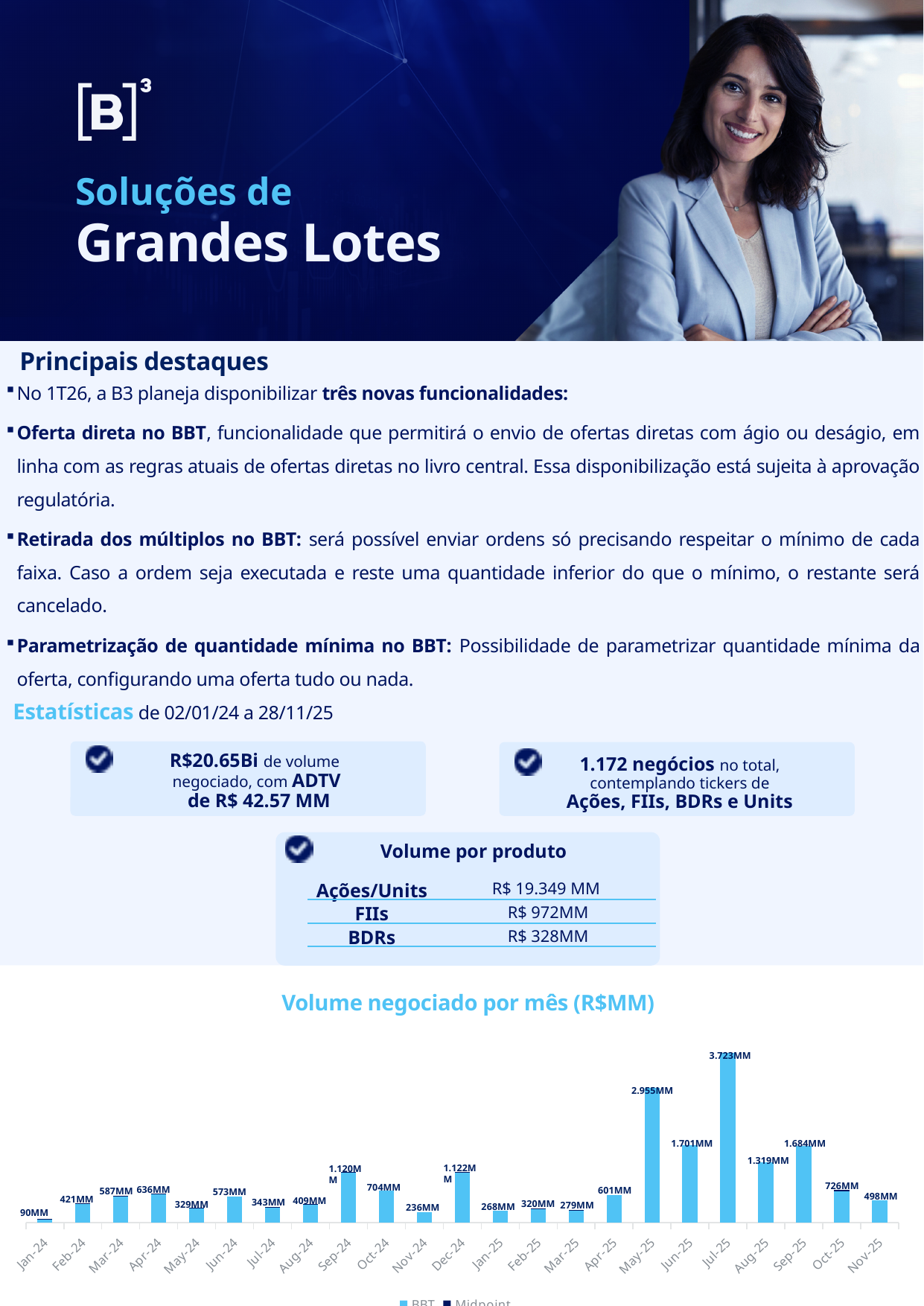
In the "Volume negociado por mês (R$MM)" chart, what is the value for Nov-25? 498MM In the "Volume negociado por mês (R$MM)" chart, do the values rise or fall from Sep-25 to Nov-25? fall How many series does the legend of the "Volume negociado por mês (R$MM)" chart list? 2 In the "Volume negociado por mês (R$MM)" chart, what is the value for Apr-25? 601MM What kind of chart is shown under the title "Volume negociado por mês (R$MM)"? bar chart In the "Volume negociado por mês (R$MM)" chart, what is the value for Jul-25? 3.723MM In the "Volume negociado por mês (R$MM)" chart, what is the value for Mar-24? 587MM In the "Volume negociado por mês (R$MM)" chart, which is larger: the value for Jun-25 or the value for Aug-25? Jun-25 In the "Volume negociado por mês (R$MM)" chart, what is the difference between the values for Jul-25 and May-25? 768MM Which month has the lowest value in the "Volume negociado por mês (R$MM)" chart? Jan-24 How many months are plotted in the "Volume negociado por mês (R$MM)" chart? 23 Which month has the highest value in the "Volume negociado por mês (R$MM)" chart? Jul-25